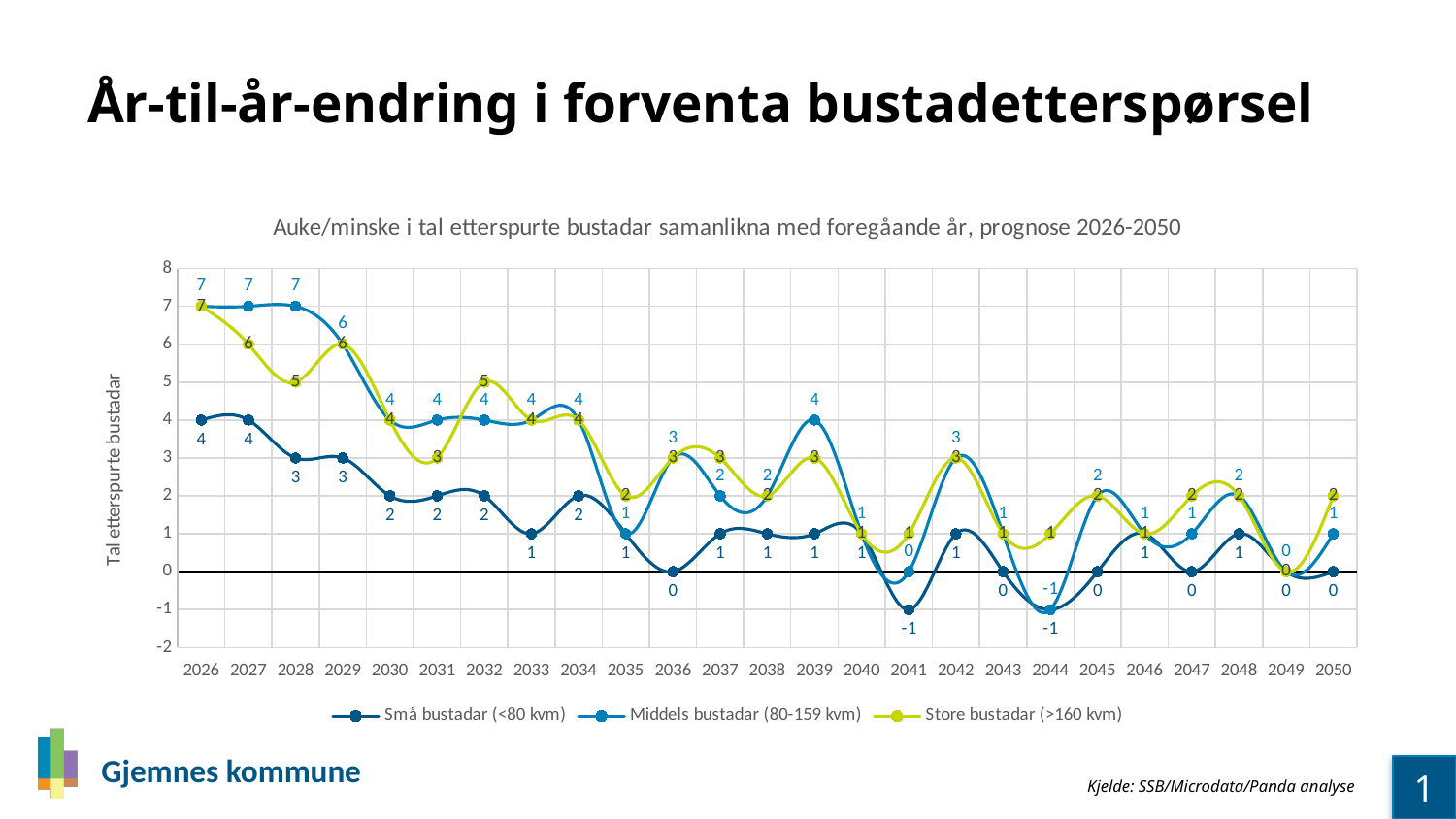
How many years are shown on the x axis? 25 Which is larger in 2028: Store bustadar (>160 kvm) or Middels bustadar (80-159 kvm)? Middels bustadar (80-159 kvm) What kind of chart is shown on the slide? Line chart What is the value for Middels bustadar (80-159 kvm) in 2029? 6 How many series does the legend list? 3 What is the value for Store bustadar (>160 kvm) in 2032? 5 In which year does Middels bustadar (80-159 kvm) reach its lowest value? 2044 Do the values for Middels bustadar (80-159 kvm) generally rise or fall from 2026 to 2050? Fall What is the value for Middels bustadar (80-159 kvm) in 2039? 4 What is the label of the y axis? Tal etterspurte bustadar What is the value for Små bustadar (<80 kvm) in 2041? -1 What is the difference between Middels bustadar (80-159 kvm) and Små bustadar (<80 kvm) in 2026? 3